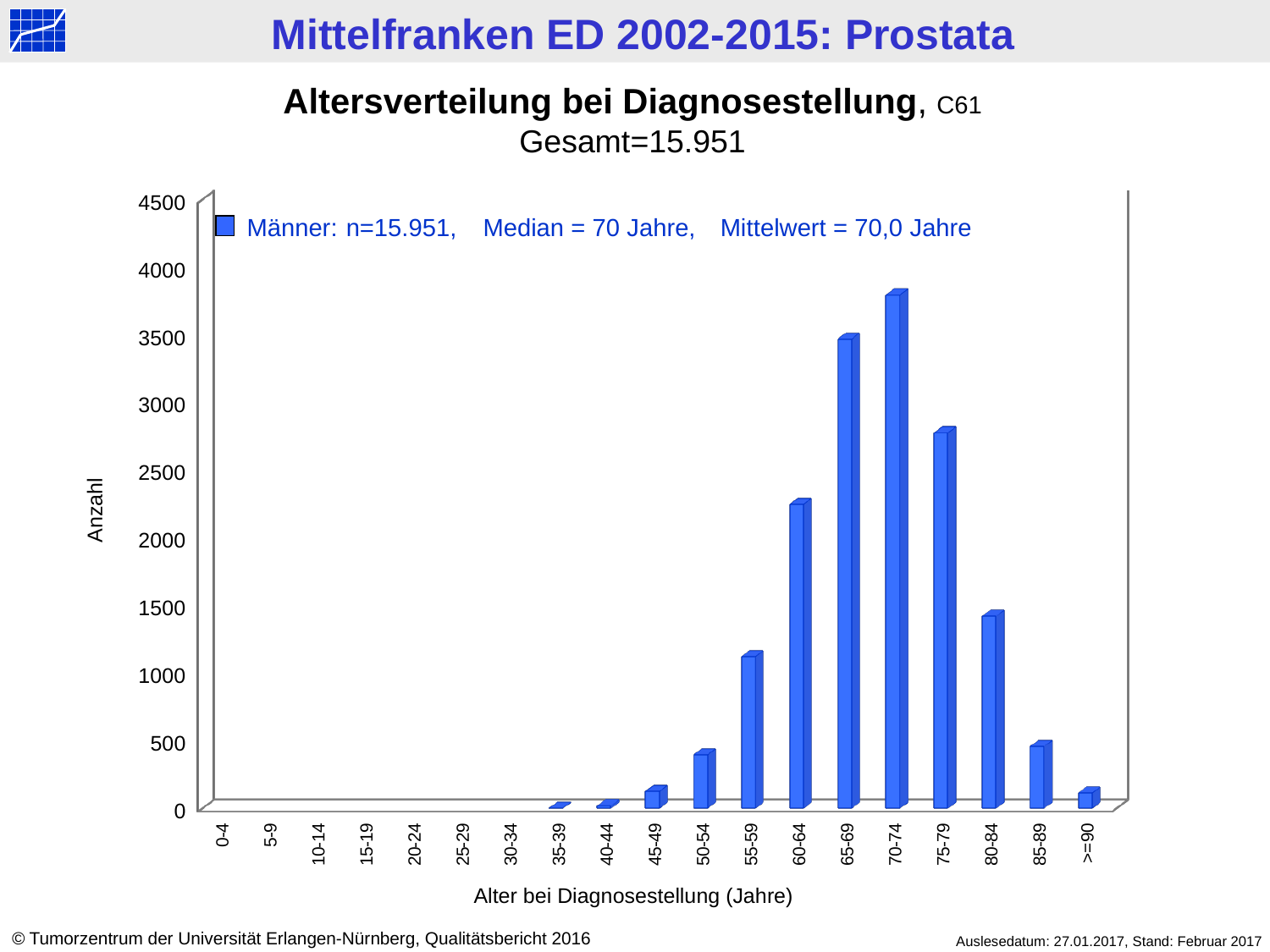
What is the label of the y axis? Anzahl What kind of chart is shown on the slide? bar chart What median age is stated in the chart legend? 70 Jahre How many age groups are shown on the x axis? 19 Which age group has the highest number of diagnoses? 70-74 Is the value for the 70-74 age group greater or less than 3500? greater Is the value for the 50-54 age group greater or less than 500? less Which age group has the larger value, 65-69 or 75-79? 65-69 Is the value for the 75-79 age group greater or less than 2500? greater How many series does the legend list? 1 Do the values rise or fall from the 70-74 age group to the >=90 age group? fall